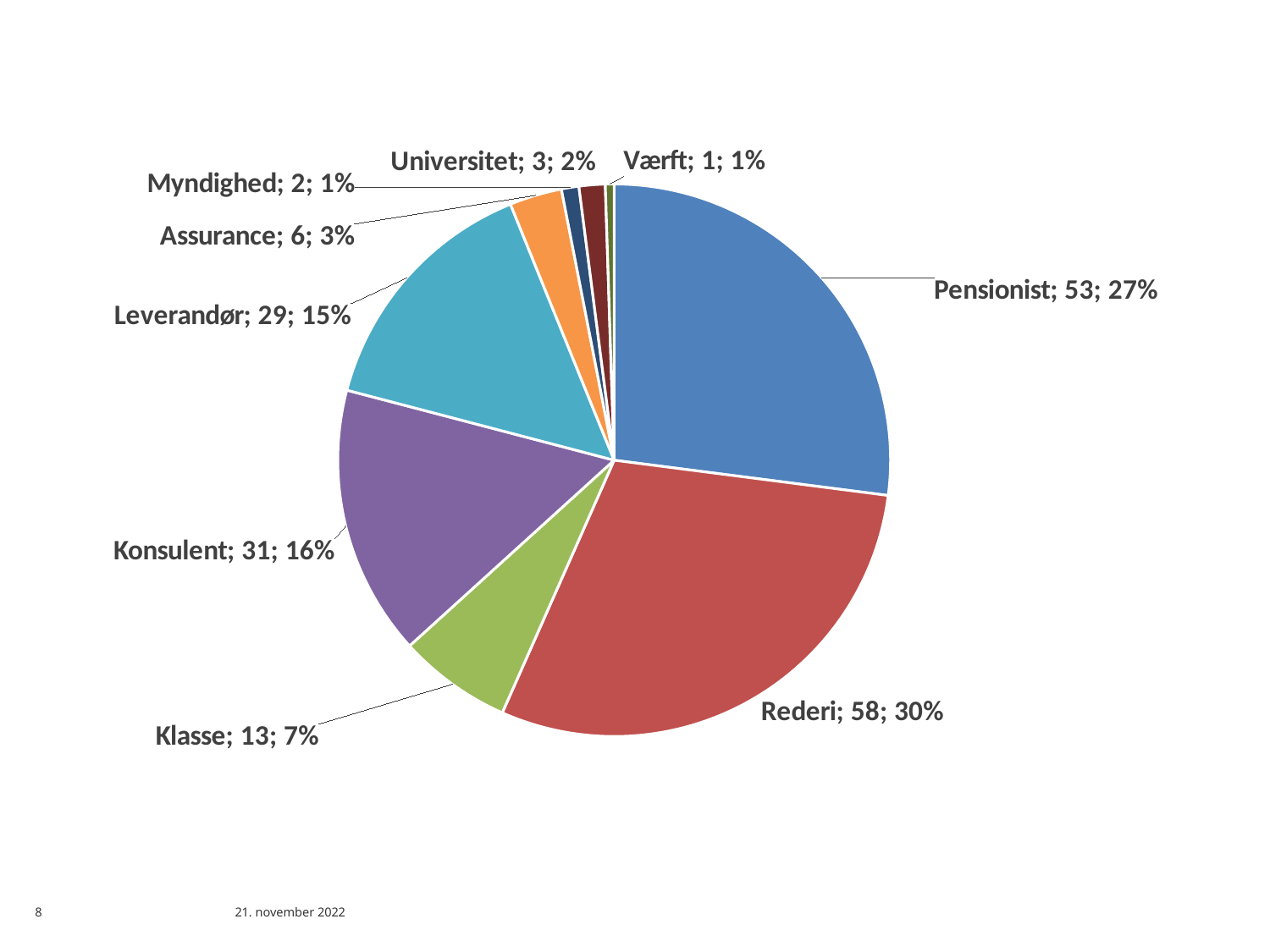
What colour is the Rederi slice? red What share of the pie does Klasse represent? 7% What is the value for Leverandør? 29 What is the value for Rederi? 58 How many categories does the pie chart have? 9 Which is larger, Konsulent or Leverandør? Konsulent What share of the pie does Pensionist represent? 27% What kind of chart is shown on the slide? pie chart Which category has the smallest slice? Værft What is the value for Assurance? 6 What is the difference between the values for Rederi and Pensionist? 5 Which category has the largest slice? Rederi